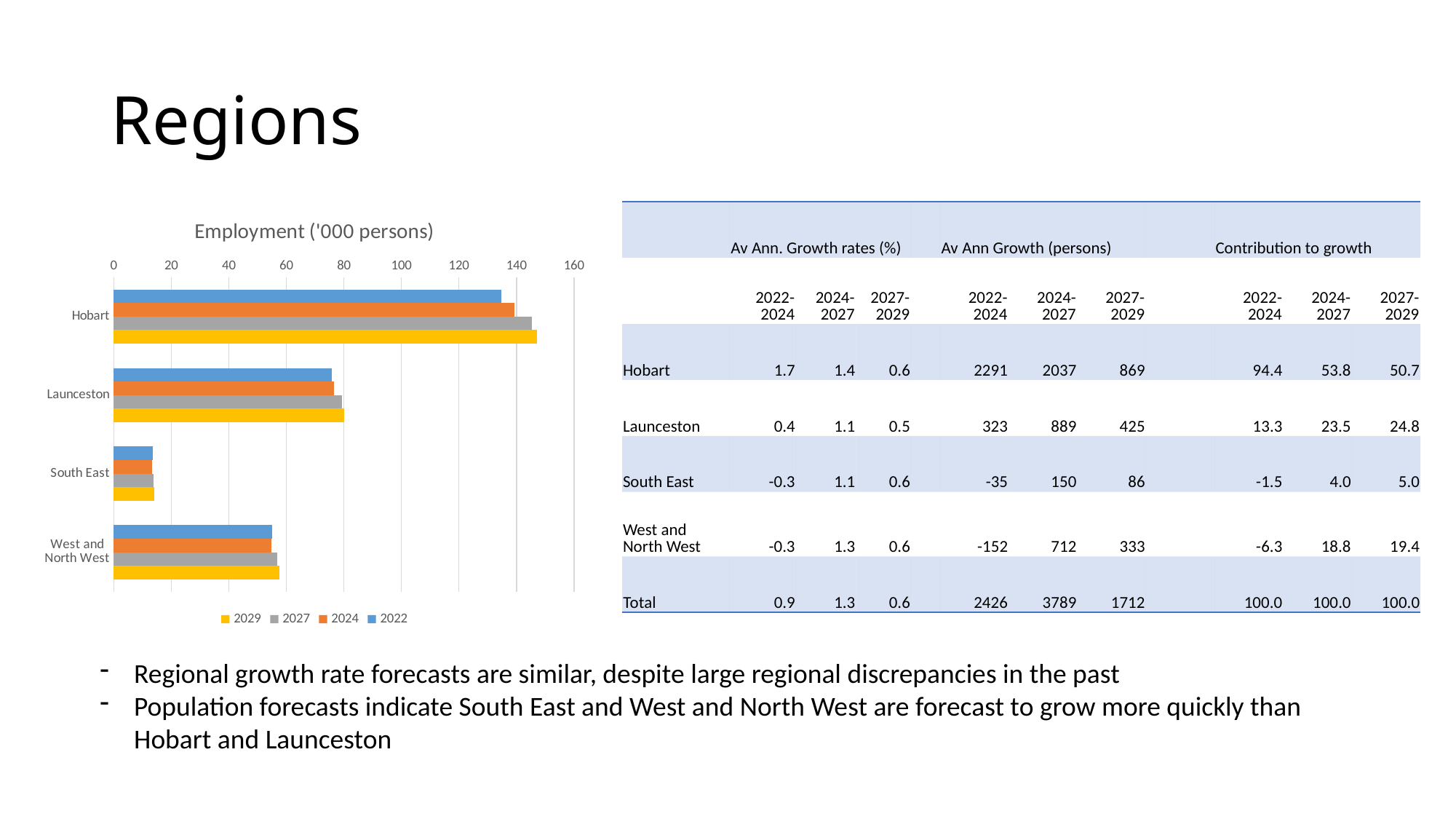
What kind of chart is shown on the slide? bar chart What is the title of the chart? Employment ('000 persons) Is the 2029 employment value for South East greater or less than 20? less Which region has the lowest employment in the chart? South East In 2029, which region has higher employment: Launceston or West and North West? Launceston Which region has the highest employment in the chart? Hobart Is the 2029 employment value for Hobart greater or less than 140? greater How many series does the chart's legend list? 4 How many regions (categories) are plotted in the chart? 4 Which years are listed in the chart's legend? 2029, 2027, 2024, 2022 Is the 2029 employment value for West and North West greater or less than 40? greater